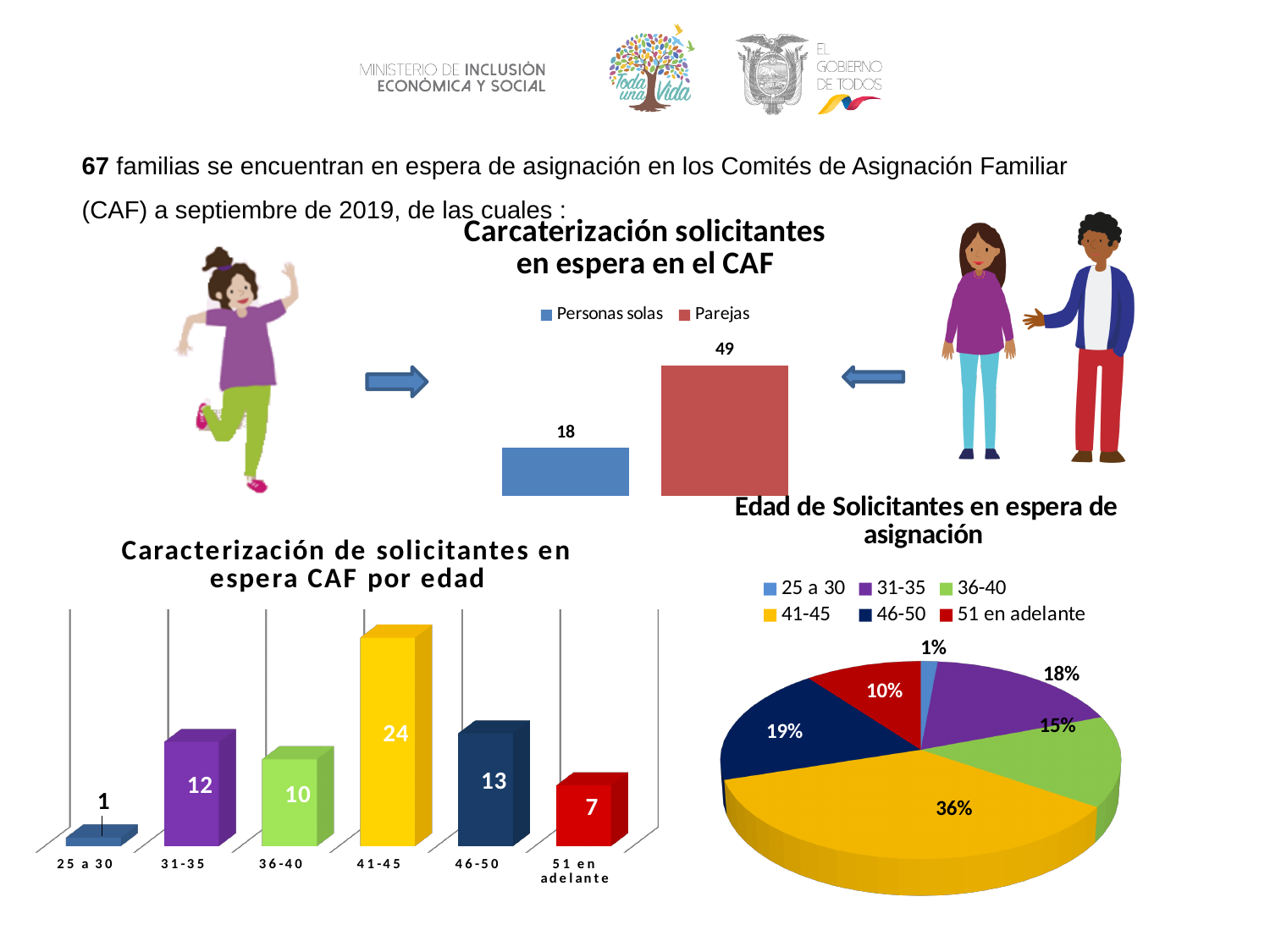
In the chart titled 'Caracterización de solicitantes en espera CAF por edad', which age group has the highest value? 41-45 What kind of chart is 'Edad de Solicitantes en espera de asignación'? Pie chart In the chart titled 'Caracterización de solicitantes en espera CAF por edad', what is the value for 41-45? 24 In the chart titled 'Carcaterización solicitantes en espera en el CAF', how many series does the legend list? 2 In the chart titled 'Caracterización de solicitantes en espera CAF por edad', how many age categories are shown? 6 In the pie chart titled 'Edad de Solicitantes en espera de asignación', what share does the 46-50 slice have? 19% In the chart titled 'Carcaterización solicitantes en espera en el CAF', what is the value for Personas solas? 18 In the chart titled 'Caracterización de solicitantes en espera CAF por edad', which is larger, 46-50 or 36-40? 46-50 In the pie chart titled 'Edad de Solicitantes en espera de asignación', what share does the 41-45 slice have? 36% In the chart titled 'Caracterización de solicitantes en espera CAF por edad', which age group has the lowest value? 25 a 30 In the chart titled 'Carcaterización solicitantes en espera en el CAF', what is the value for Parejas? 49 In the chart titled 'Carcaterización solicitantes en espera en el CAF', what is the difference between Parejas and Personas solas? 31